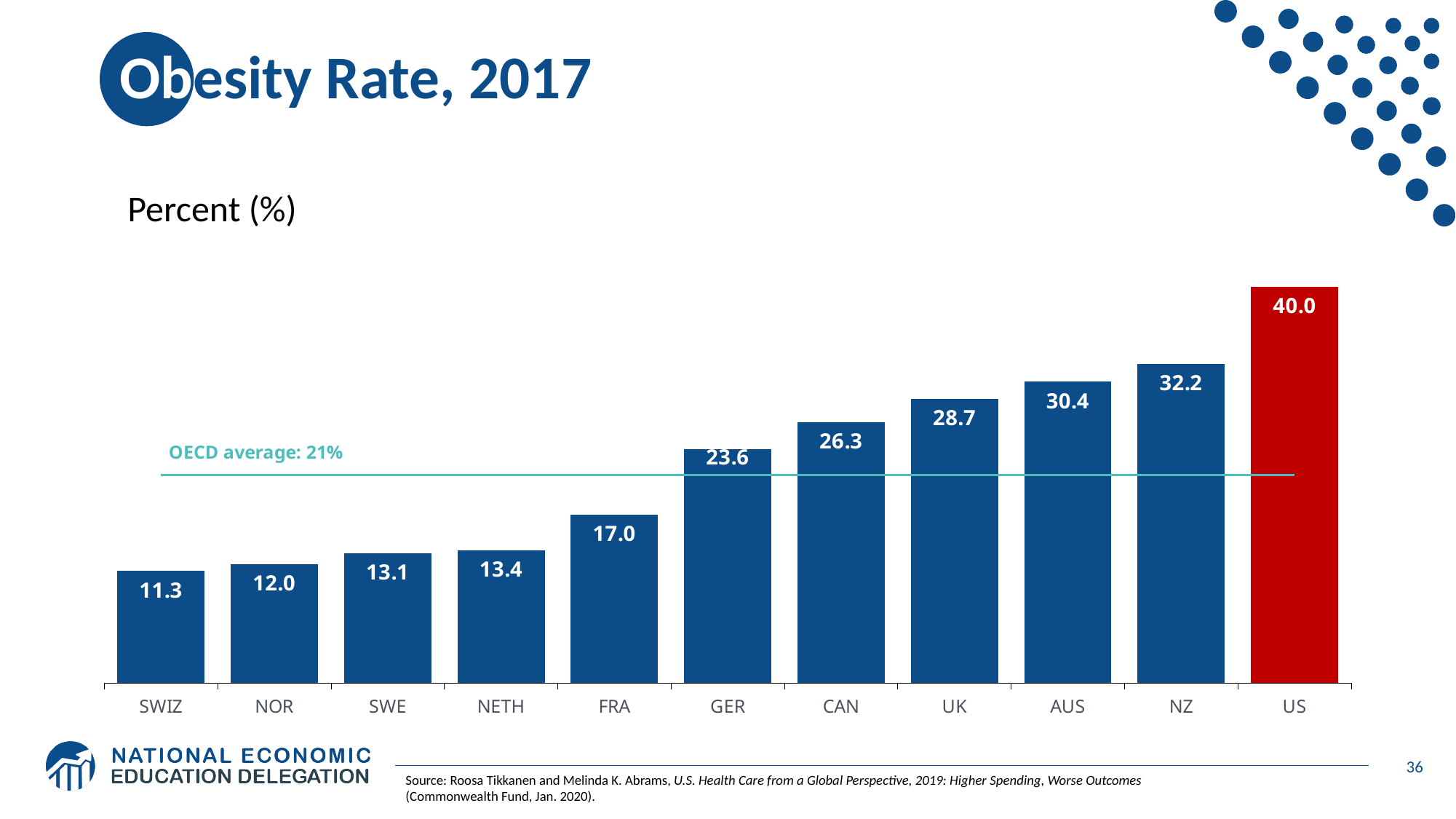
What is the obesity rate shown for the Netherlands (NETH)? 13.4 What is the obesity rate shown for Germany (GER)? 23.6 Which country has the highest obesity rate on the chart? US What kind of chart is shown on the slide? Bar chart Which has a higher obesity rate, Canada (CAN) or Australia (AUS)? AUS What is the difference between the obesity rates of the UK and France (FRA)? 11.7 What OECD average value is marked by the horizontal line on the chart? 21% Which country has the lowest obesity rate on the chart? SWIZ How many countries are shown on the chart? 11 Do the obesity rates rise or fall moving from left to right across the chart? Rise What is the difference between the obesity rates of the US and NZ? 7.8 What is the obesity rate shown for the US? 40.0